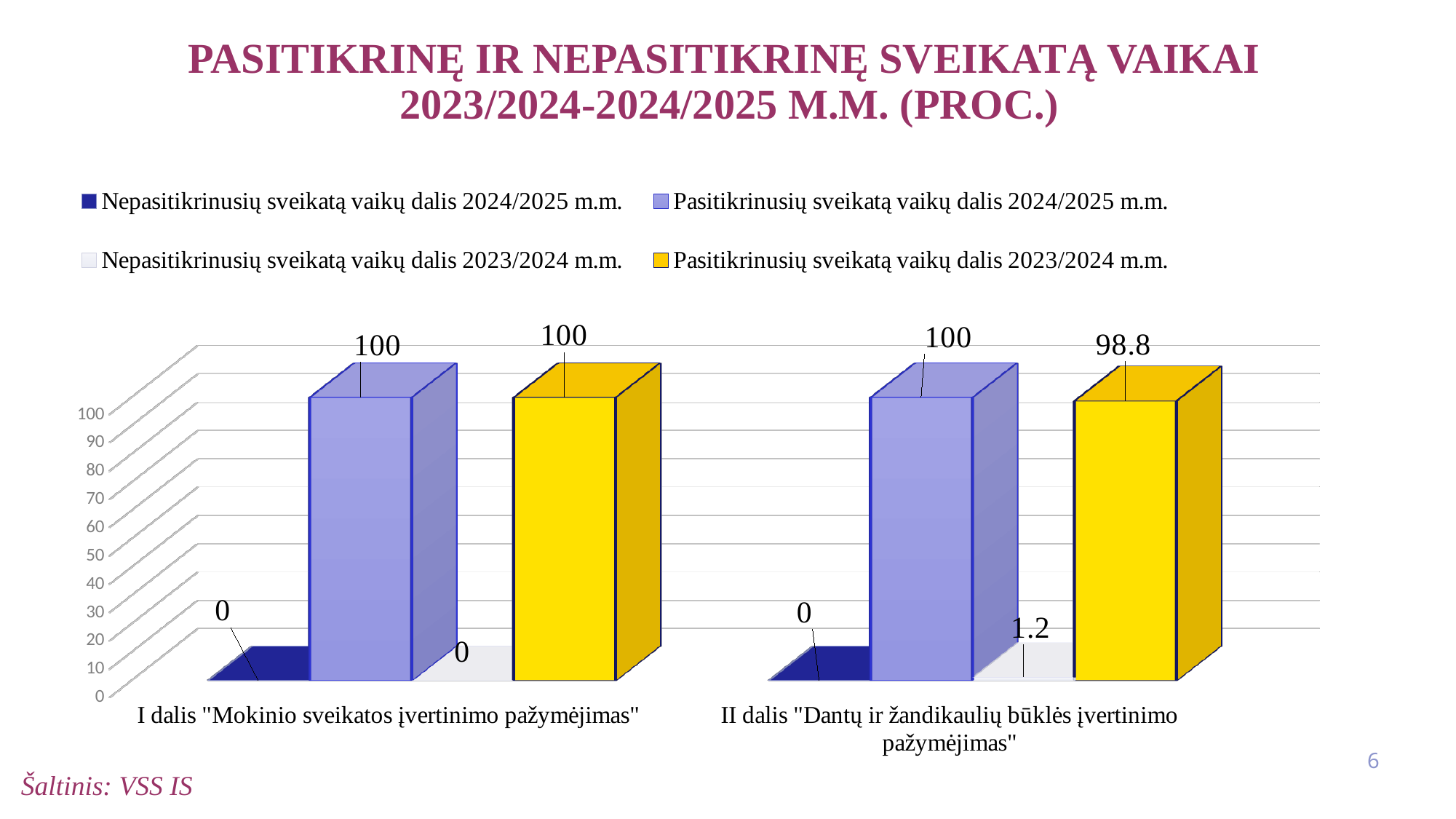
For II dalis "Dantų ir žandikaulių būklės įvertinimo pažymėjimas", which is larger: "Pasitikrinusių sveikatą vaikų dalis 2024/2025 m.m." or "Pasitikrinusių sveikatą vaikų dalis 2023/2024 m.m."? Pasitikrinusių sveikatą vaikų dalis 2024/2025 m.m. How many categories are shown on the x axis? 2 What kind of chart is shown on the slide? bar chart What is the value of "Nepasitikrinusių sveikatą vaikų dalis 2023/2024 m.m." for II dalis "Dantų ir žandikaulių būklės įvertinimo pažymėjimas"? 1.2 What is the value of "Pasitikrinusių sveikatą vaikų dalis 2023/2024 m.m." for II dalis "Dantų ir žandikaulių būklės įvertinimo pažymėjimas"? 98.8 How many series does the legend list? 4 Which category has the lowest value for "Pasitikrinusių sveikatą vaikų dalis 2023/2024 m.m."? II dalis "Dantų ir žandikaulių būklės įvertinimo pažymėjimas" What colour are the bars for "Pasitikrinusių sveikatą vaikų dalis 2023/2024 m.m."? yellow Is the value of "Pasitikrinusių sveikatą vaikų dalis 2023/2024 m.m." for II dalis "Dantų ir žandikaulių būklės įvertinimo pažymėjimas" greater or less than 90? greater What is the value of "Nepasitikrinusių sveikatą vaikų dalis 2024/2025 m.m." for I dalis "Mokinio sveikatos įvertinimo pažymėjimas"? 0 What is the value of "Pasitikrinusių sveikatą vaikų dalis 2024/2025 m.m." for I dalis "Mokinio sveikatos įvertinimo pažymėjimas"? 100 What is the difference between the "Pasitikrinusių sveikatą vaikų dalis 2024/2025 m.m." and "Pasitikrinusių sveikatą vaikų dalis 2023/2024 m.m." values for II dalis "Dantų ir žandikaulių būklės įvertinimo pažymėjimas"? 1.2